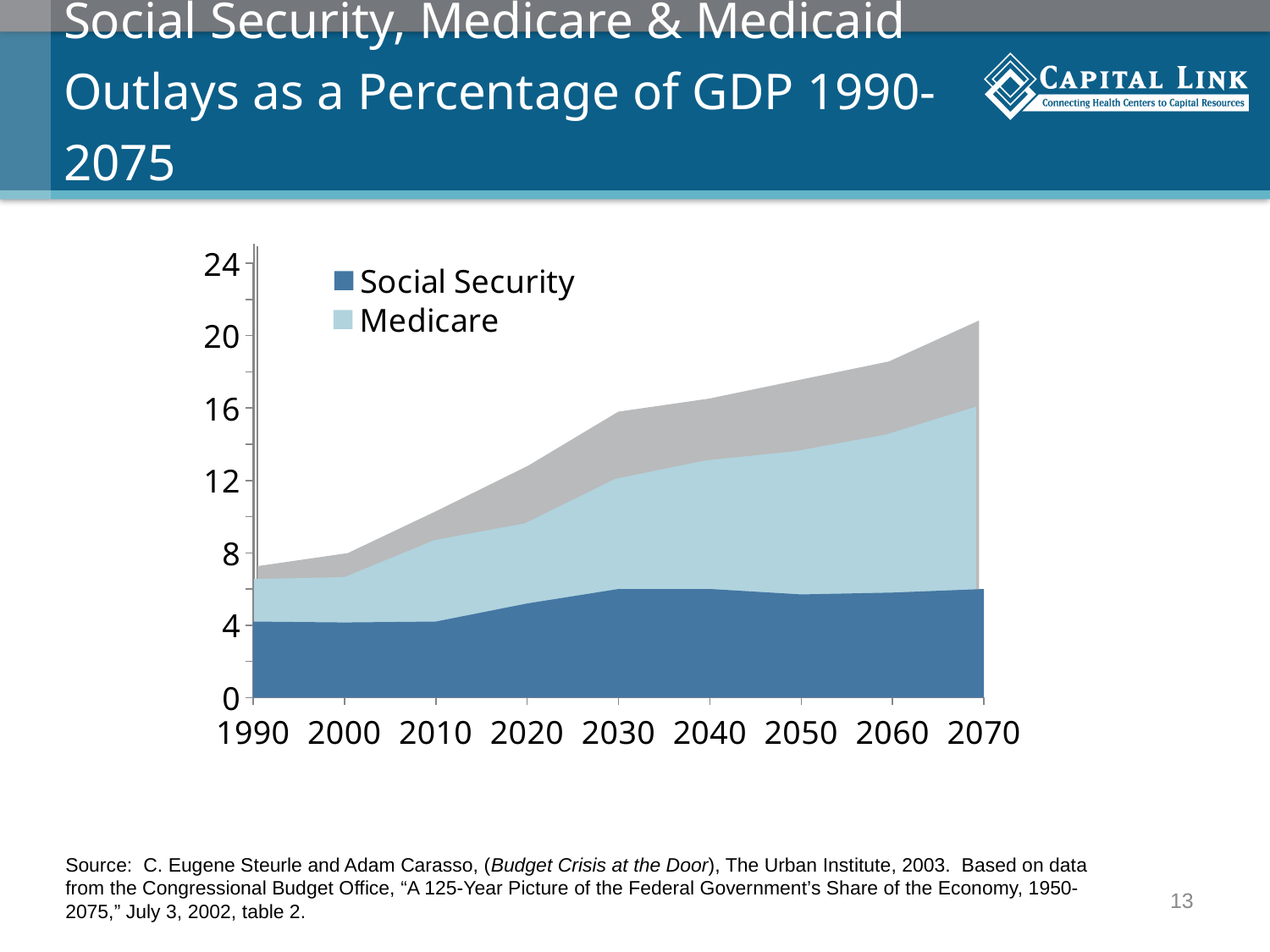
Does the total stacked value rise or fall from 1990 to 2070? Rise What is the first year shown on the x axis? 1990 Is the total stacked value in 1990 greater or less than 8? less What is the last year shown on the x axis? 2070 Is the Social Security value in 2070 greater or less than 8? less How many series does the legend list? 2 Is the total stacked value in 2010 greater or less than 8? greater How many year labels are shown along the x axis? 9 What colour is used for the Social Security series? Dark blue Which series are named in the legend? Social Security and Medicare What kind of chart is shown on the slide? Stacked area chart